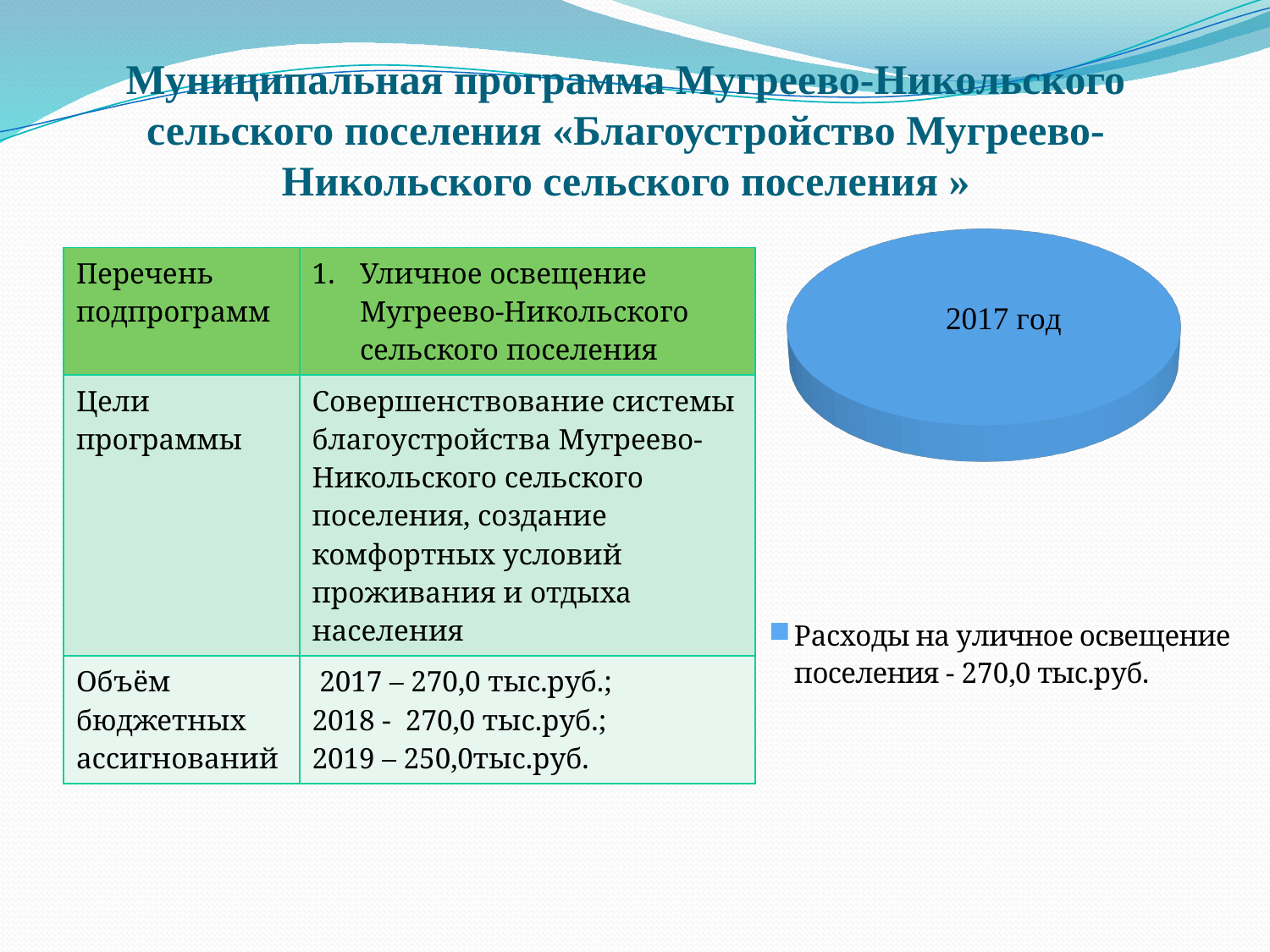
What share of the pie chart does the slice for street lighting expenses (Расходы на уличное освещение поселения) take up? 100% According to the pie chart legend, what is the value of street lighting expenses (Расходы на уличное освещение поселения) for 2017? 270,0 тыс.руб. What is the title of the pie chart? 2017 год What kind of chart is shown on the right side of the slide? pie chart What is the legend entry of the pie chart? Расходы на уличное освещение поселения - 270,0 тыс.руб. How many slices does the pie chart have? 1 How many entries does the legend of the pie chart list? 1